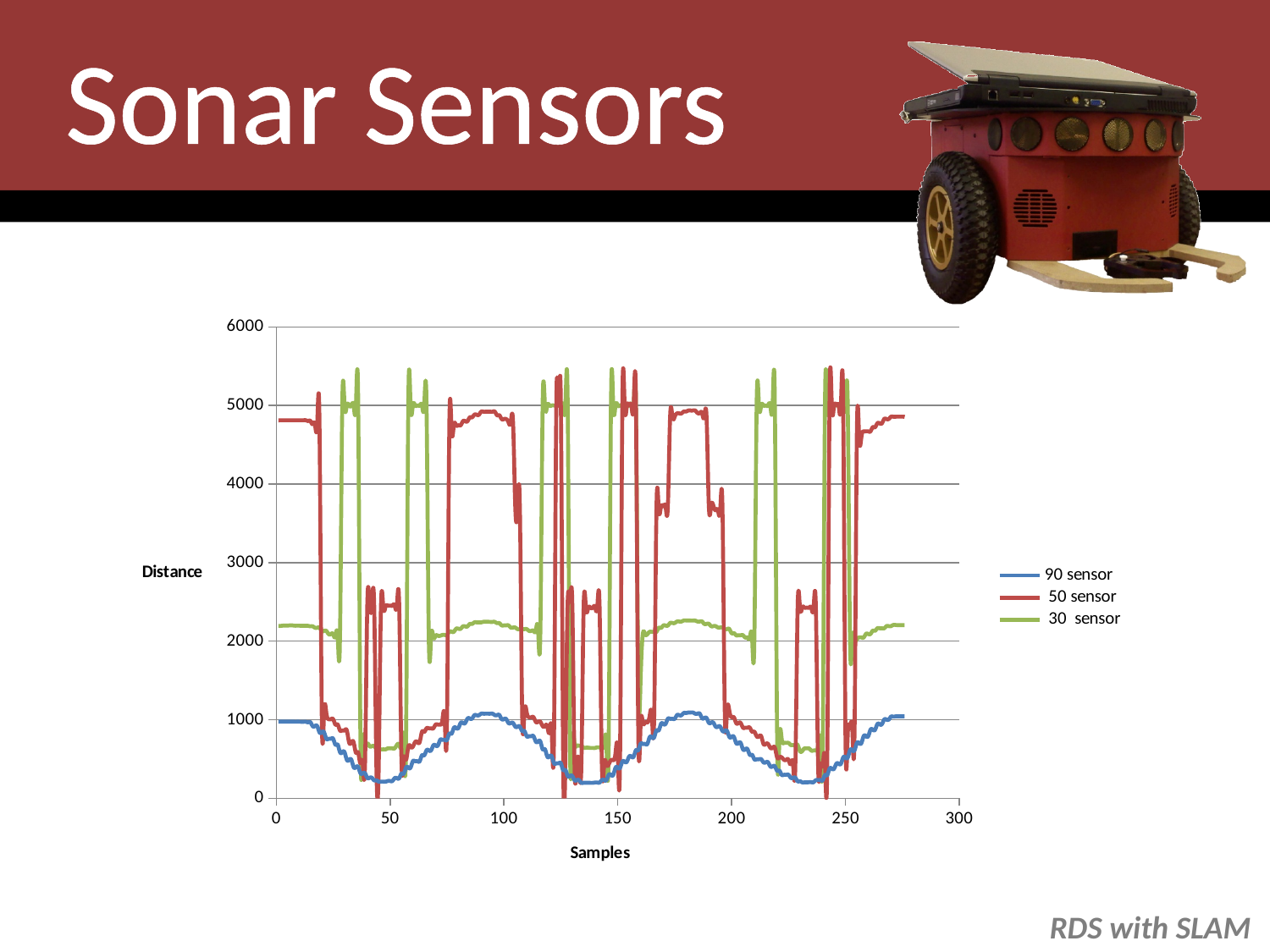
How many series does the legend list? 3 Is the value of the 30 sensor series at sample 0 greater or less than 1000? greater What is the label of the vertical axis? Distance Is the value of the 50 sensor series at sample 0 greater or less than 4000? greater At sample 180, which series has the larger value: 50 sensor or 30 sensor? 50 sensor Is the value of the 90 sensor series at sample 50 greater or less than 1000? less What kind of chart is shown on the slide? line chart What are the three series named in the legend? 90 sensor, 50 sensor, 30 sensor At sample 0, which series has the larger value: 50 sensor or 90 sensor? 50 sensor At sample 100, which series has the larger value: 30 sensor or 90 sensor? 30 sensor